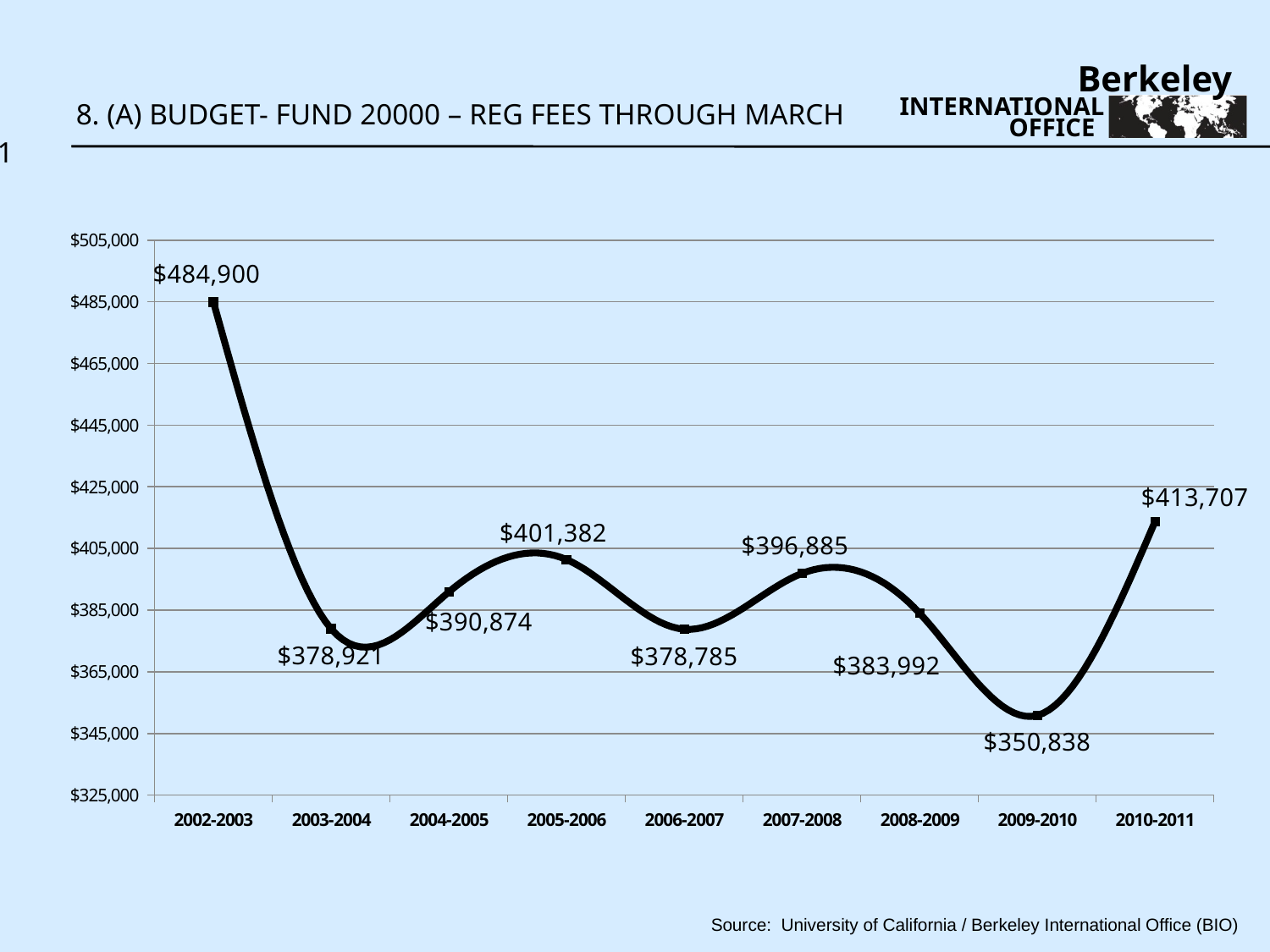
Which is larger, the value for 2007-2008 or the value for 2008-2009? 2007-2008 What is the difference between the values for 2010-2011 and 2009-2010? $62,869 How many years are plotted on the chart? 9 Which year has the lowest value? 2009-2010 Which year has the highest value? 2002-2003 What kind of chart is shown on the slide? line chart What is the value for 2002-2003? $484,900 Does the value rise or fall from 2009-2010 to 2010-2011? rise What is the value for 2005-2006? $401,382 What is the value for 2010-2011? $413,707 What is the value for 2009-2010? $350,838 What is the difference between the values for 2002-2003 and 2010-2011? $71,193